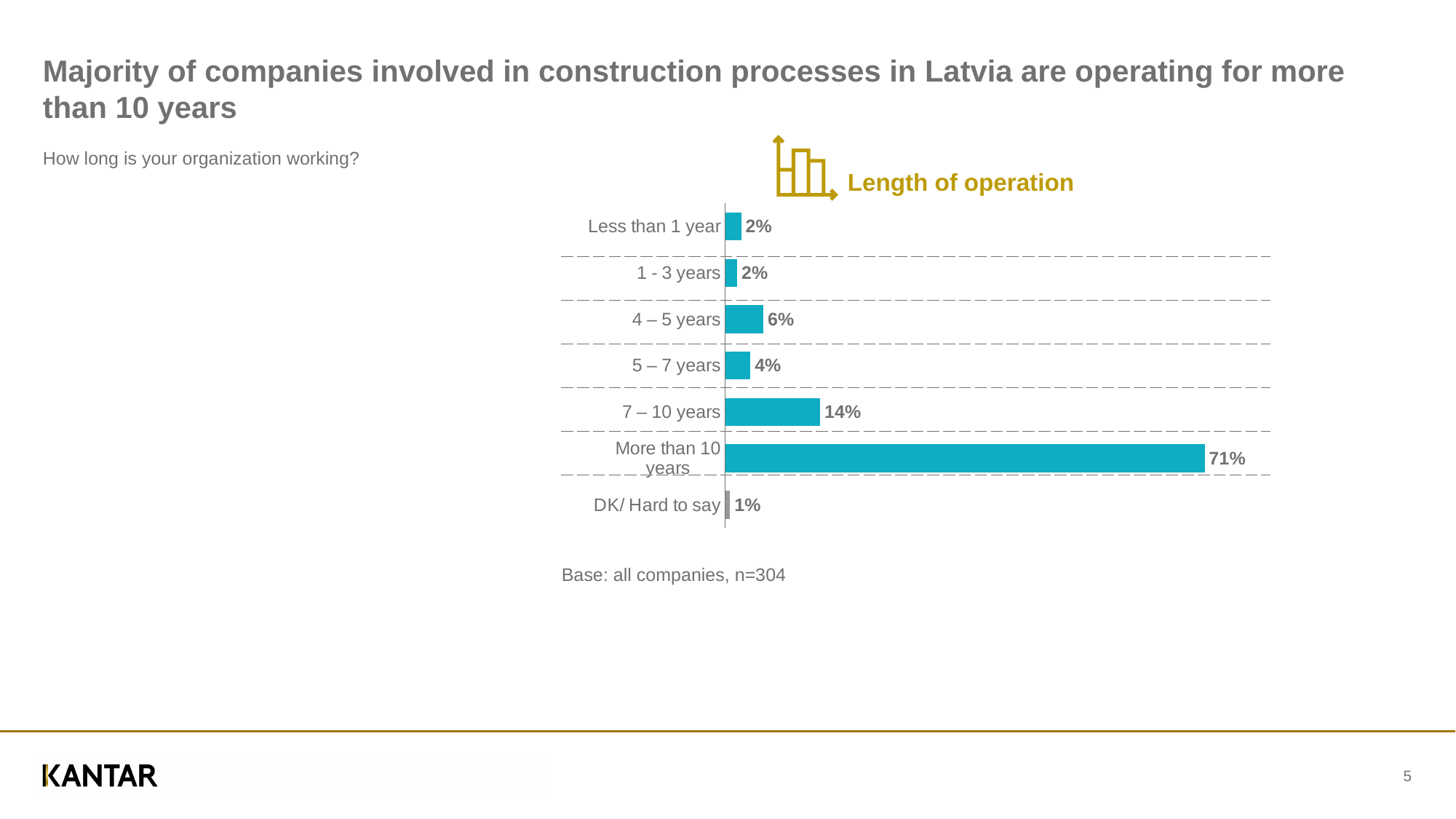
What is the title of the chart? Length of operation How many categories are shown in the chart? 7 What is the value for the 7 – 10 years category? 14% What kind of chart is shown on the slide? Bar chart What percentage of companies answered DK/ Hard to say? 1% What is the difference between the values for More than 10 years and 7 – 10 years? 57 percentage points Which is larger, the value for 4 – 5 years or the value for 5 – 7 years? 4 – 5 years What is the value for the 4 – 5 years category? 6% Which category has the lowest value? DK/ Hard to say What is the base size stated below the chart? n=304 Which category has the highest value? More than 10 years What percentage of companies have been operating for more than 10 years? 71%